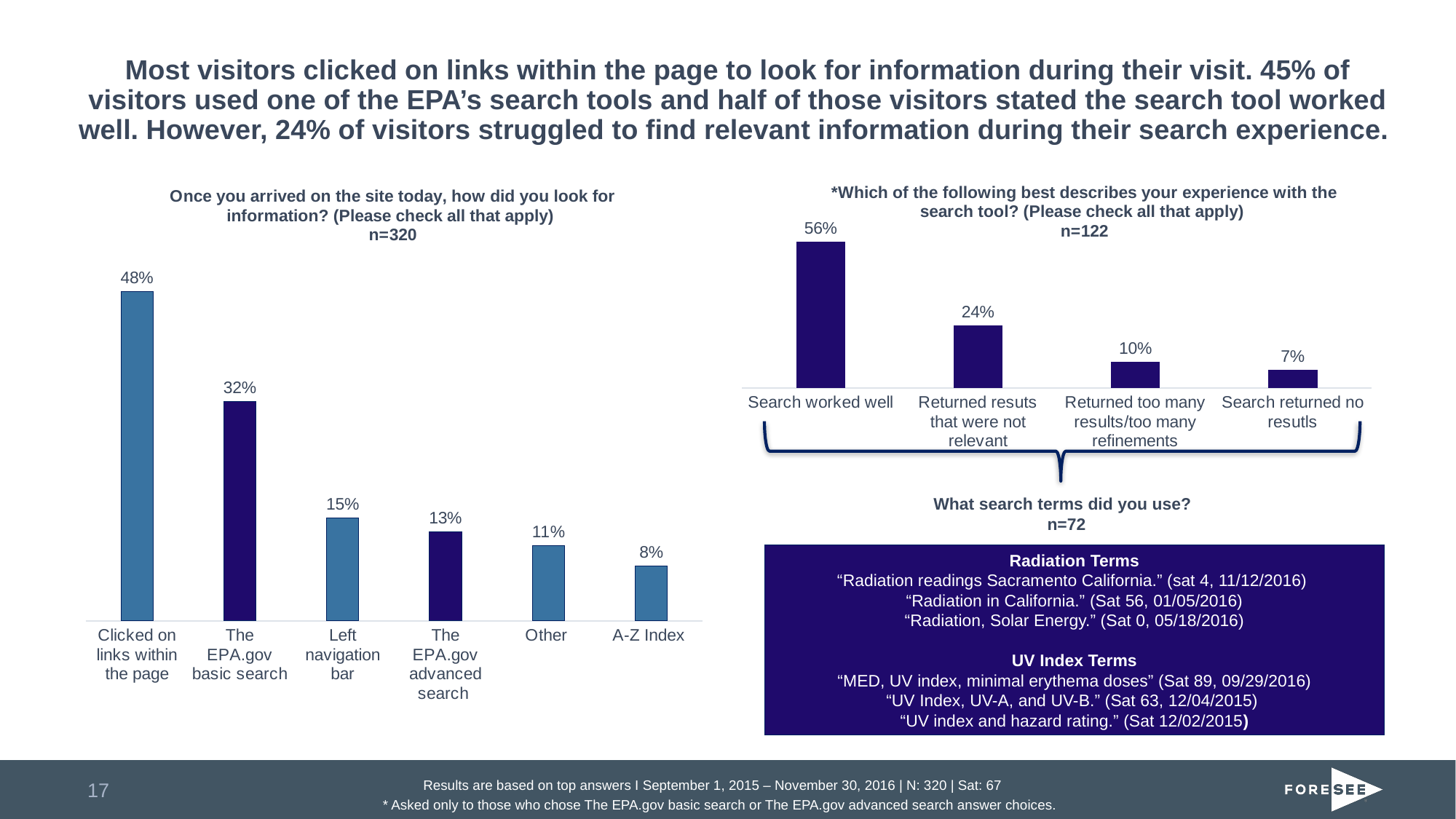
In the right chart ('Which of the following best describes your experience with the search tool?'), what percentage said the search returned no results? 7% In the right chart ('Which of the following best describes your experience with the search tool?'), which category has the highest value? Search worked well What is the sample size (n) shown in the title of the right chart ('Which of the following best describes your experience with the search tool?')? n=122 In the right chart ('Which of the following best describes your experience with the search tool?'), what percentage said the search worked well? 56% In the left chart ('Once you arrived on the site today, how did you look for information?'), what percentage used the EPA.gov advanced search? 13% In the right chart ('Which of the following best describes your experience with the search tool?'), what is the difference between 'Search worked well' and 'Returned results that were not relevant'? 32% In the left chart ('Once you arrived on the site today, how did you look for information?'), how many categories are shown? 6 What type of chart is the right chart ('Which of the following best describes your experience with the search tool?')? Bar chart In the left chart ('Once you arrived on the site today, how did you look for information?'), what is the difference between 'The EPA.gov basic search' and 'Left navigation bar'? 17% In the left chart ('Once you arrived on the site today, how did you look for information?'), which category has the lowest value? A-Z Index In the left chart ('Once you arrived on the site today, how did you look for information?'), what percentage of visitors clicked on links within the page? 48% In the left chart ('Once you arrived on the site today, how did you look for information?'), which is larger: 'Other' or 'A-Z Index'? Other